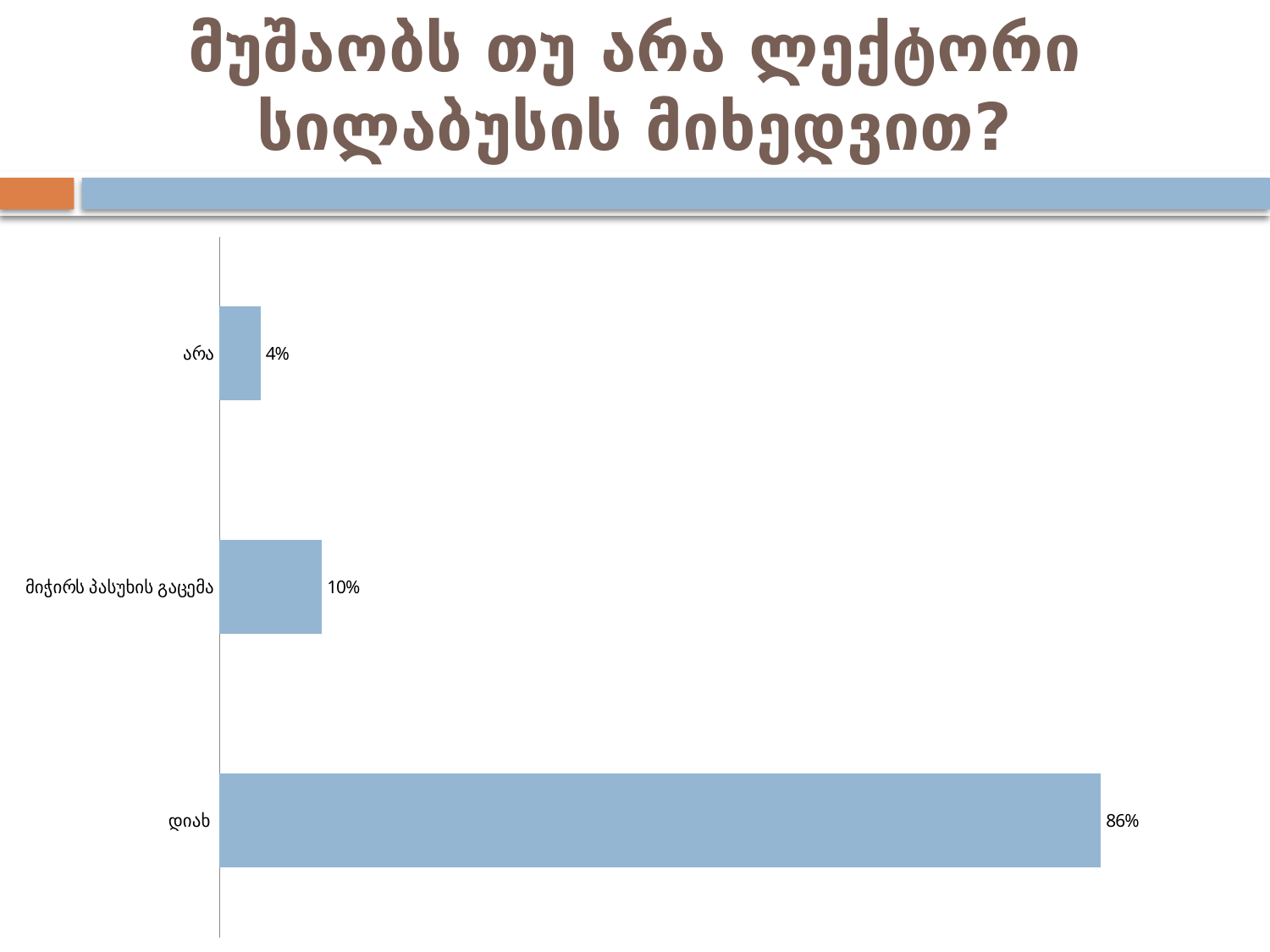
What is the difference between the values for "დიახ" and "მიჭირს პასუხის გაცემა"? 76% What colour are the bars in the chart? light blue What is the difference between the values for "მიჭირს პასუხის გაცემა" and "არა"? 6% What kind of chart is shown on the slide? bar chart What is the value for "არა"? 4% What is the title of the slide? მუშაობს თუ არა ლექტორი სილაბუსის მიხედვით? Which category has the highest value? დიახ What is the value for "მიჭირს პასუხის გაცემა"? 10% Which is larger, the value for "არა" or the value for "მიჭირს პასუხის გაცემა"? მიჭირს პასუხის გაცემა How many categories are shown in the chart? 3 Which category has the lowest value? არა What is the value for "დიახ"? 86%